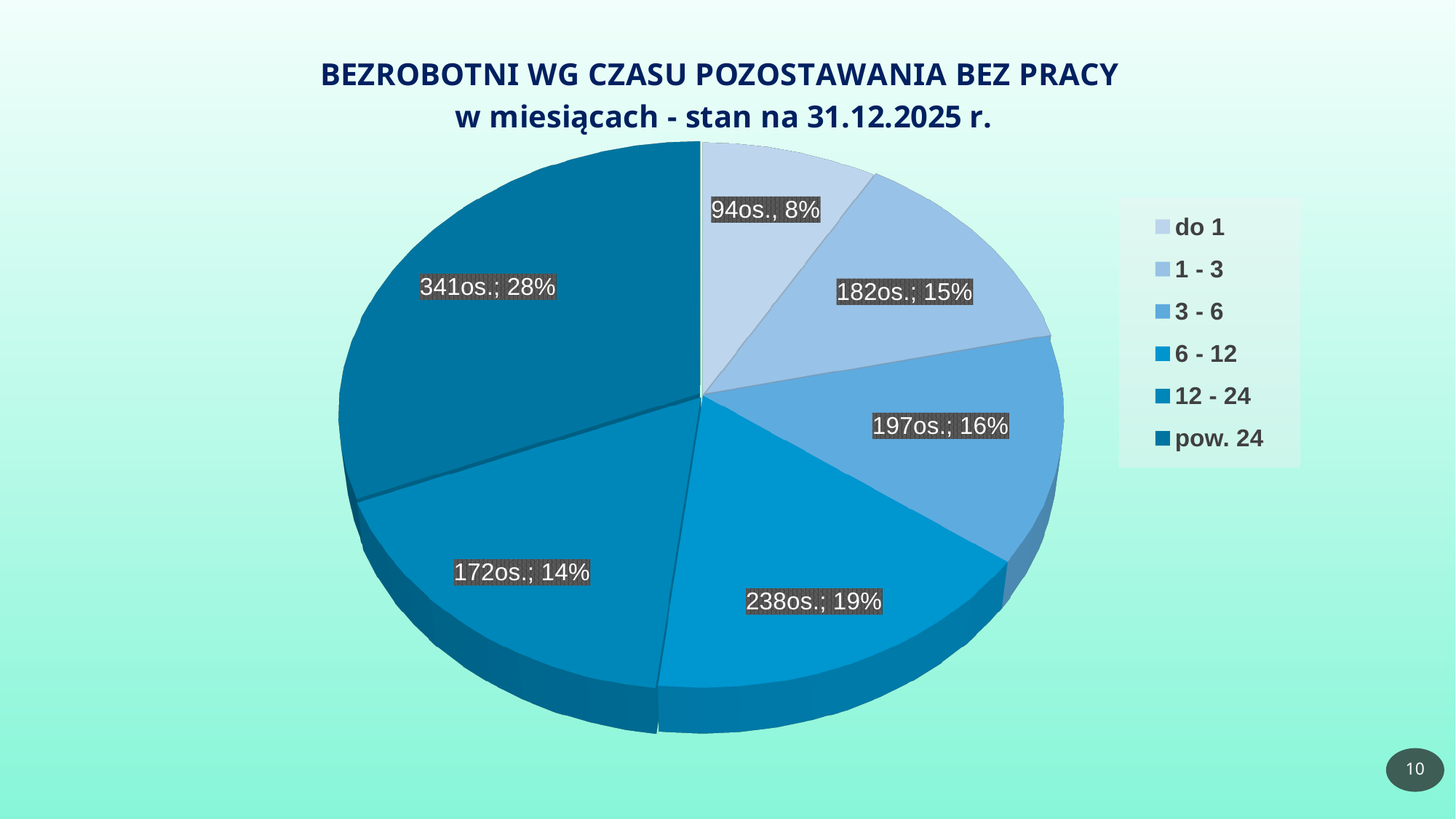
What share of the pie does the '3 - 6' slice represent? 16% Which category has more people, '1 - 3' or '12 - 24'? 1 - 3 Which category has the largest slice? pow. 24 What is the difference in number of people between 'pow. 24' and '6 - 12'? 103 How many entries does the legend list? 6 Which category has the smallest slice? do 1 How many people are in the '6 - 12' category? 238os. How many people are in the 'do 1' category? 94os. What kind of chart is shown on the slide? pie chart What is the title of the chart? BEZROBOTNI WG CZASU POZOSTAWANIA BEZ PRACY w miesiącach - stan na 31.12.2025 r. How many slices does the pie chart have? 6 What share of the pie does the 'pow. 24' slice represent? 28%